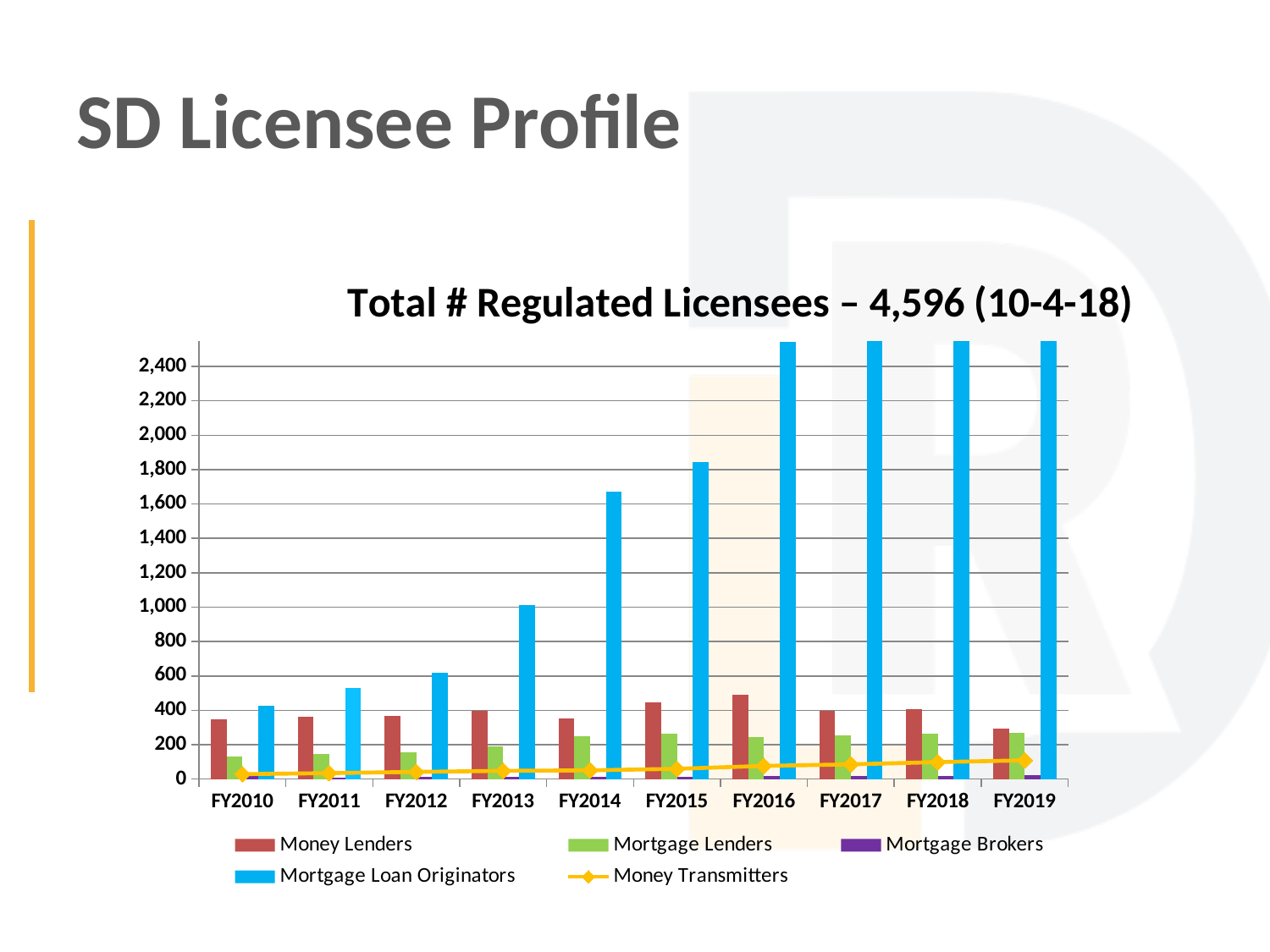
What is the title of the chart? Total # Regulated Licensees – 4,596 (10-4-18) Is the value for Mortgage Loan Originators in FY2014 greater or less than 1,600? greater Is the value for Money Lenders in FY2019 greater or less than 400? less What kind of chart is shown on the slide? A bar chart combined with a line Is the value for Mortgage Loan Originators in FY2016 greater or less than 2,400? greater How many fiscal years are shown on the x axis of the chart? 10 Which series has the lowest value in FY2019? Mortgage Brokers How many series does the chart's legend list? 5 Do the values for Mortgage Loan Originators rise or fall from FY2010 to FY2019? Rise Which series is plotted as a line rather than bars? Money Transmitters Which series has the highest value in FY2019? Mortgage Loan Originators